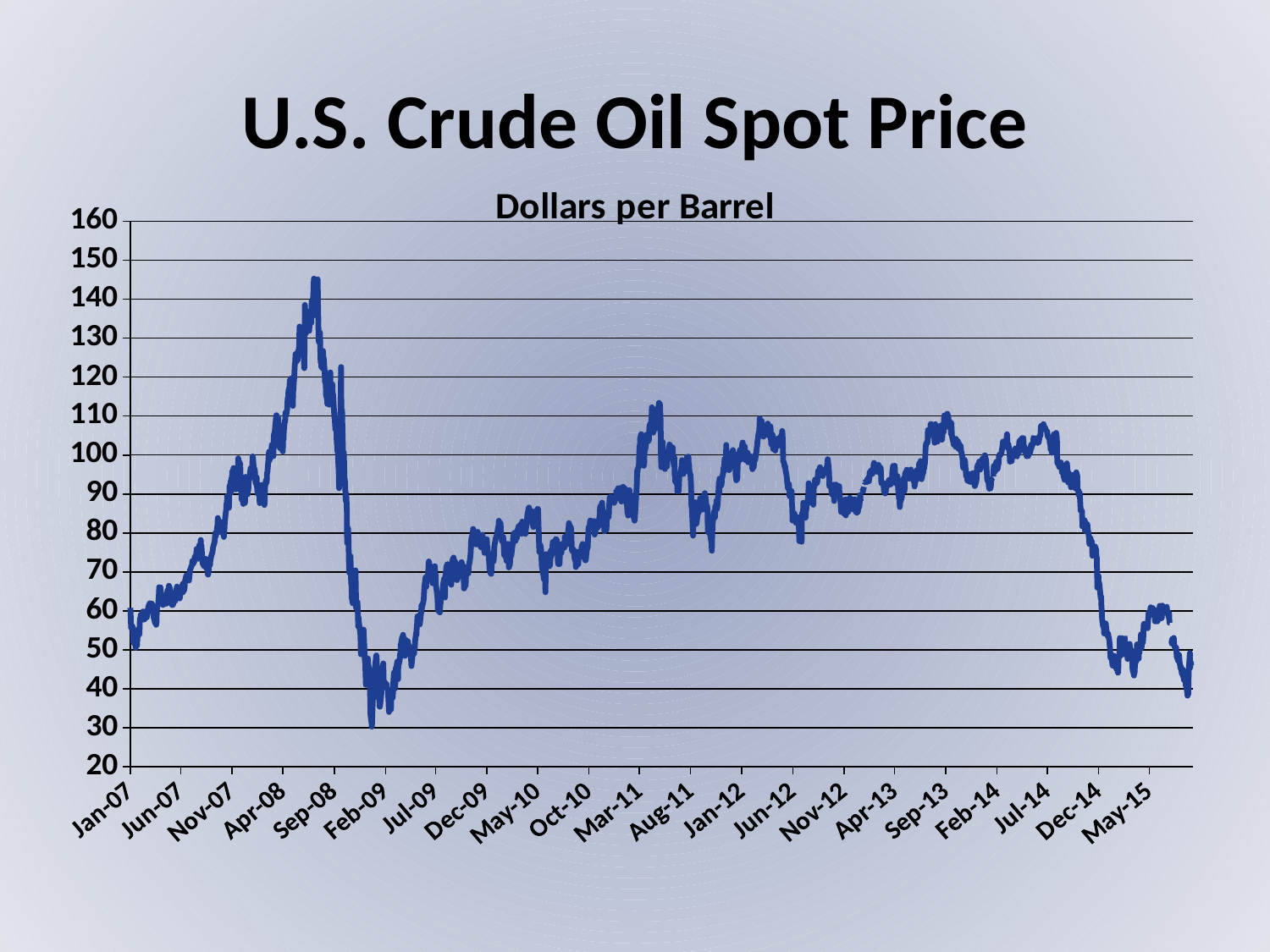
Is the crude oil spot price at Sep-13 greater or less than 100? greater What unit is the crude oil price plotted in, according to the chart subtitle? Dollars per Barrel Does the crude oil spot price rise or fall between Jan-07 and Sep-08? rise Is the crude oil spot price at Dec-14 greater or less than 80? less Is the crude oil spot price at Jan-07 greater or less than 80? less How many date labels are shown along the x axis? 21 What is the title of the chart on the slide? U.S. Crude Oil Spot Price What kind of chart is shown on the slide? line chart What is the highest value shown on the y axis? 160 Does the crude oil spot price rise or fall between Jul-14 and Dec-14? fall